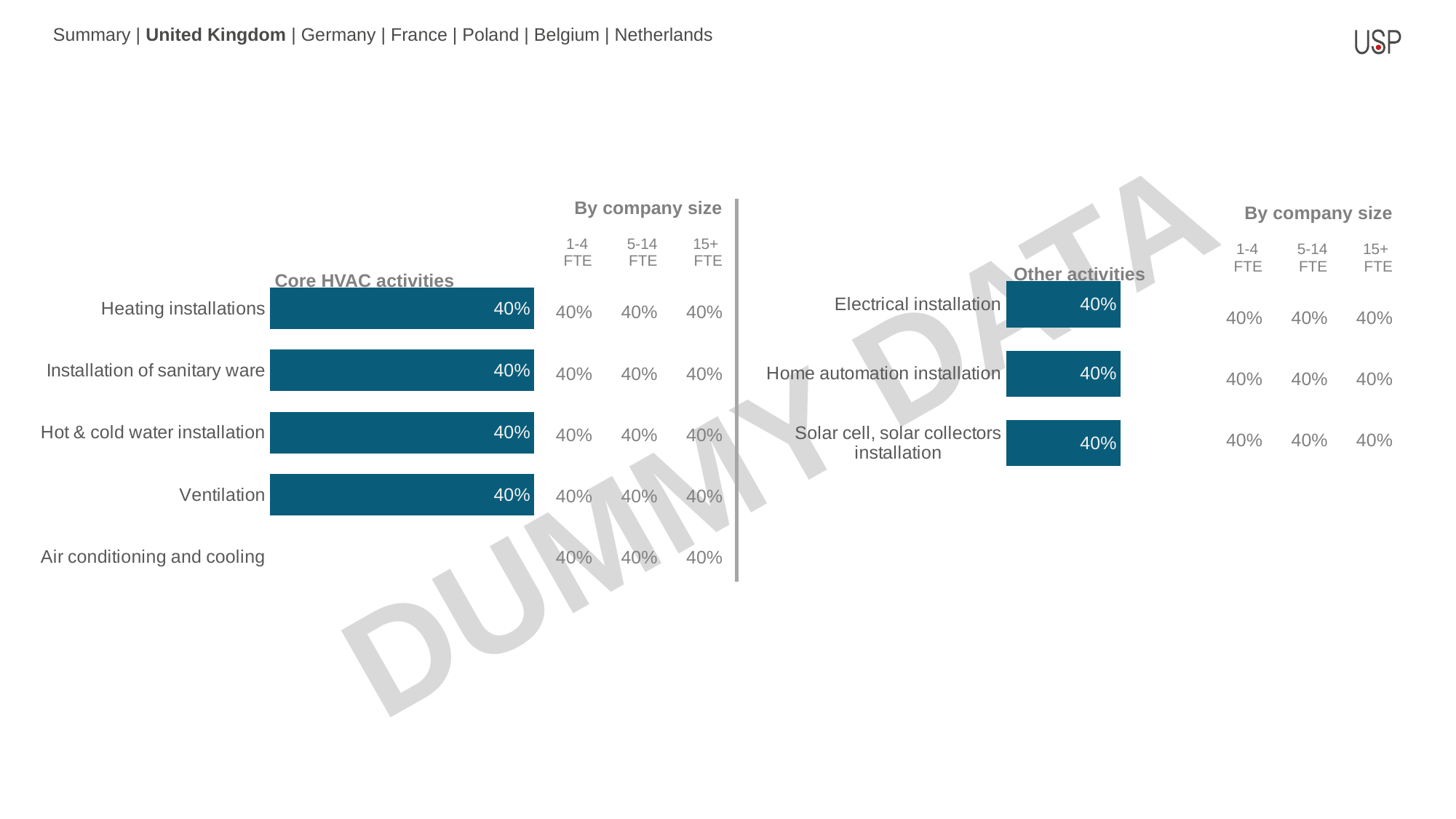
In the Core HVAC activities chart, what is the difference between the values for Heating installations and Installation of sanitary ware? 0% In the Core HVAC activities chart, what is the value for Ventilation? 40% In the Core HVAC activities chart, what is the value for Heating installations? 40% What colour are the bars in the Core HVAC activities chart? dark teal blue In the Other activities chart, what is the value for Electrical installation? 40% What kind of chart is the Other activities chart? bar chart What is the title of the chart on the left side of the slide? Core HVAC activities How many bars are plotted in the Core HVAC activities chart? 4 In the Other activities chart, what is the value for Home automation installation? 40% How many categories are plotted in the Other activities chart? 3 In the Core HVAC activities chart, what is the value for Hot & cold water installation? 40% In the Other activities chart, what is the value for Solar cell, solar collectors installation? 40%